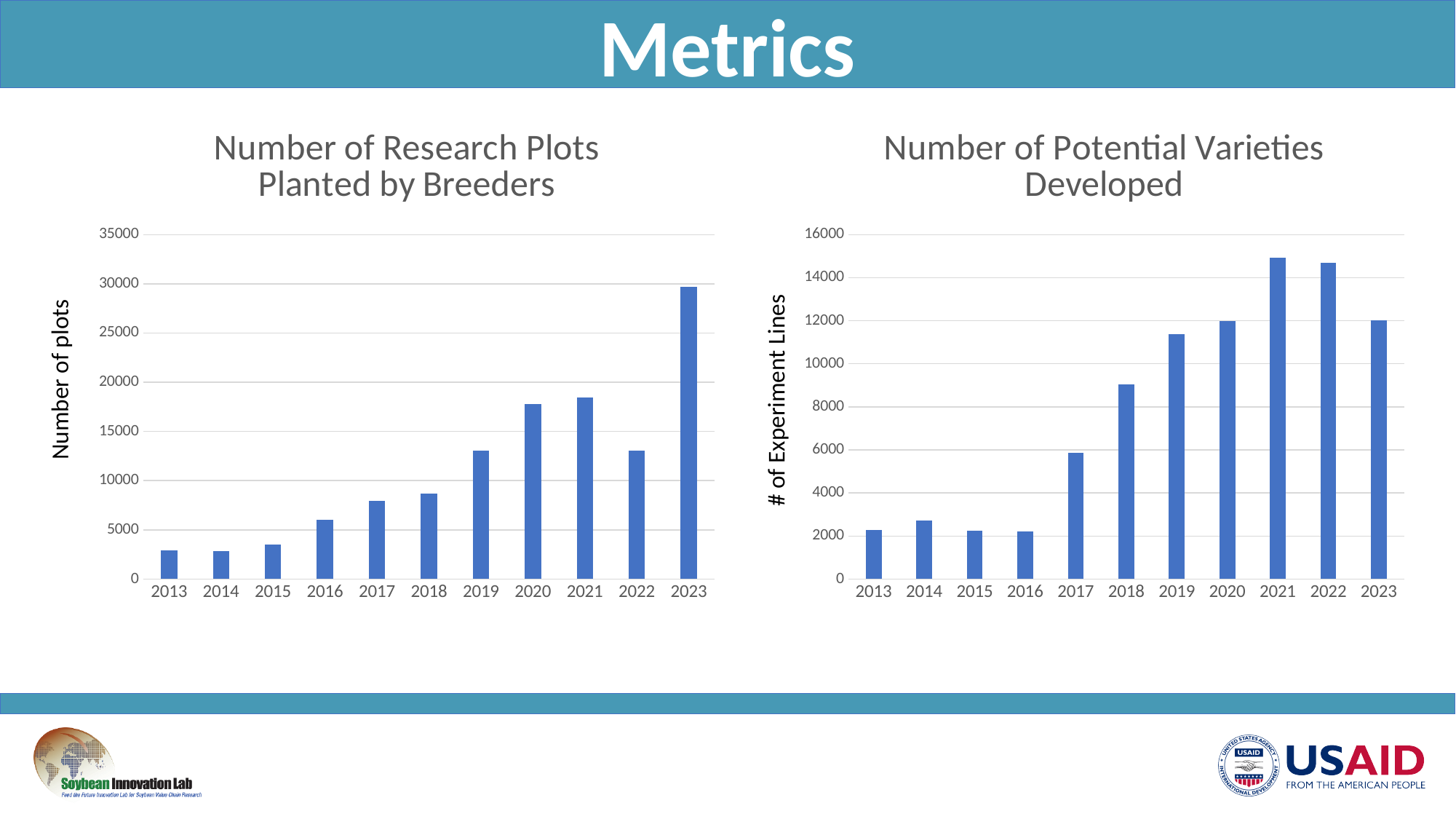
What is the y-axis label of the 'Number of Research Plots Planted by Breeders' chart? Number of plots On the 'Number of Potential Varieties Developed' chart, is the value for 2021 greater or less than 14000? greater On the 'Number of Potential Varieties Developed' chart, which year has the larger value, 2016 or 2019? 2019 What type of chart is the 'Number of Potential Varieties Developed' chart? Bar chart On the 'Number of Research Plots Planted by Breeders' chart, is the value for 2016 greater or less than 5000? greater What is the y-axis label of the 'Number of Potential Varieties Developed' chart? # of Experiment Lines On the 'Number of Potential Varieties Developed' chart, is the value for 2018 greater or less than 8000? greater On the 'Number of Research Plots Planted by Breeders' chart, which year has the larger value, 2020 or 2022? 2020 How many years are shown on the 'Number of Research Plots Planted by Breeders' chart? 11 On the 'Number of Research Plots Planted by Breeders' chart, which year has the highest value? 2023